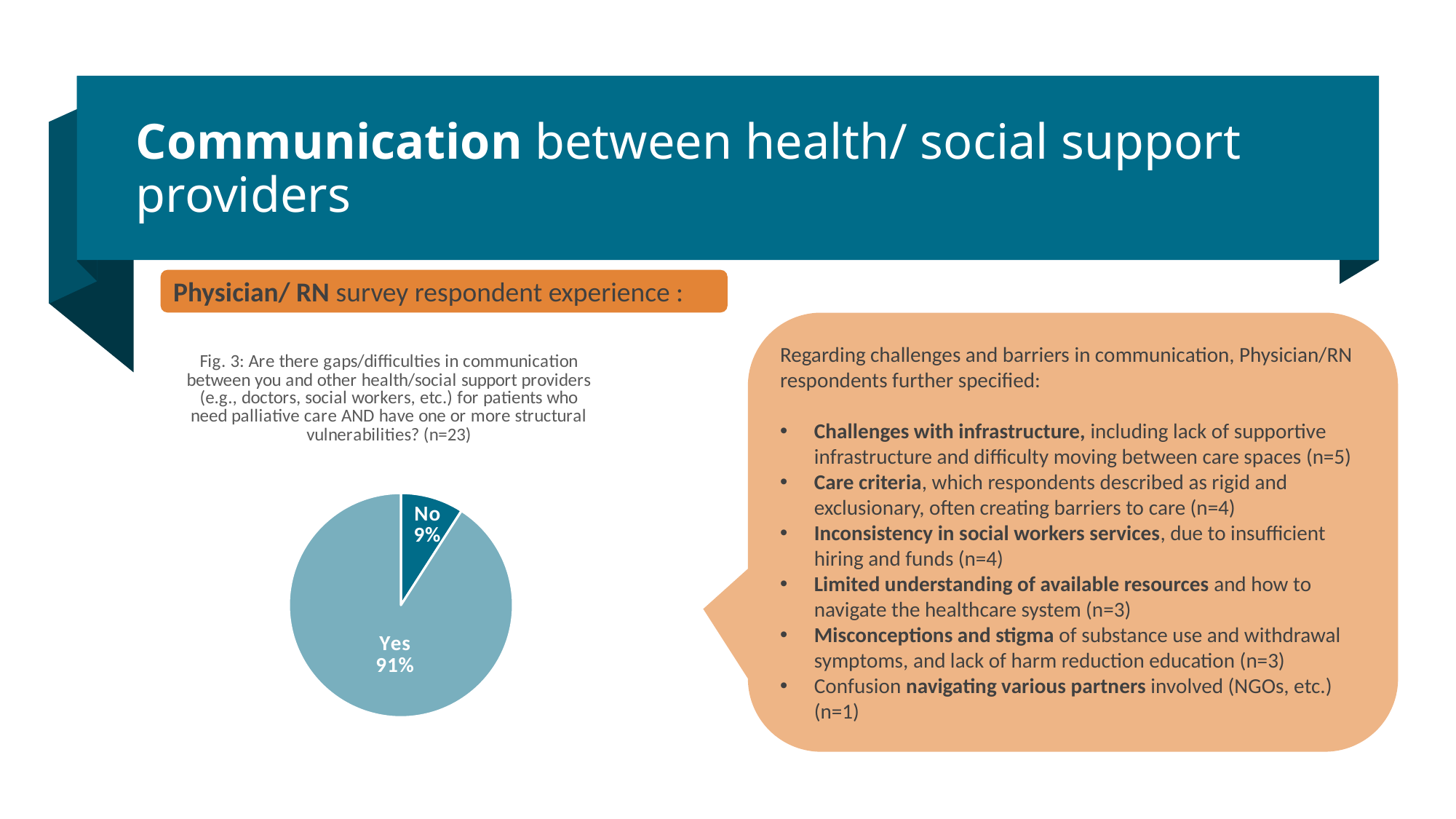
How many slices does the pie chart have? 2 What percentage of respondents answered Yes in the pie chart? 91% Which response has the largest slice of the pie chart? Yes What kind of chart is shown on the slide? pie chart Which response has the smallest slice of the pie chart? No What share of the pie does the No slice represent? 9% What figure number is given in the caption above the pie chart? Fig. 3 Which slice is larger, Yes or No? Yes How many respondents (n) does the pie chart's figure caption report? 23 What is the difference in percentage points between the Yes and No slices? 82 What percentage of respondents answered No in the pie chart? 9%